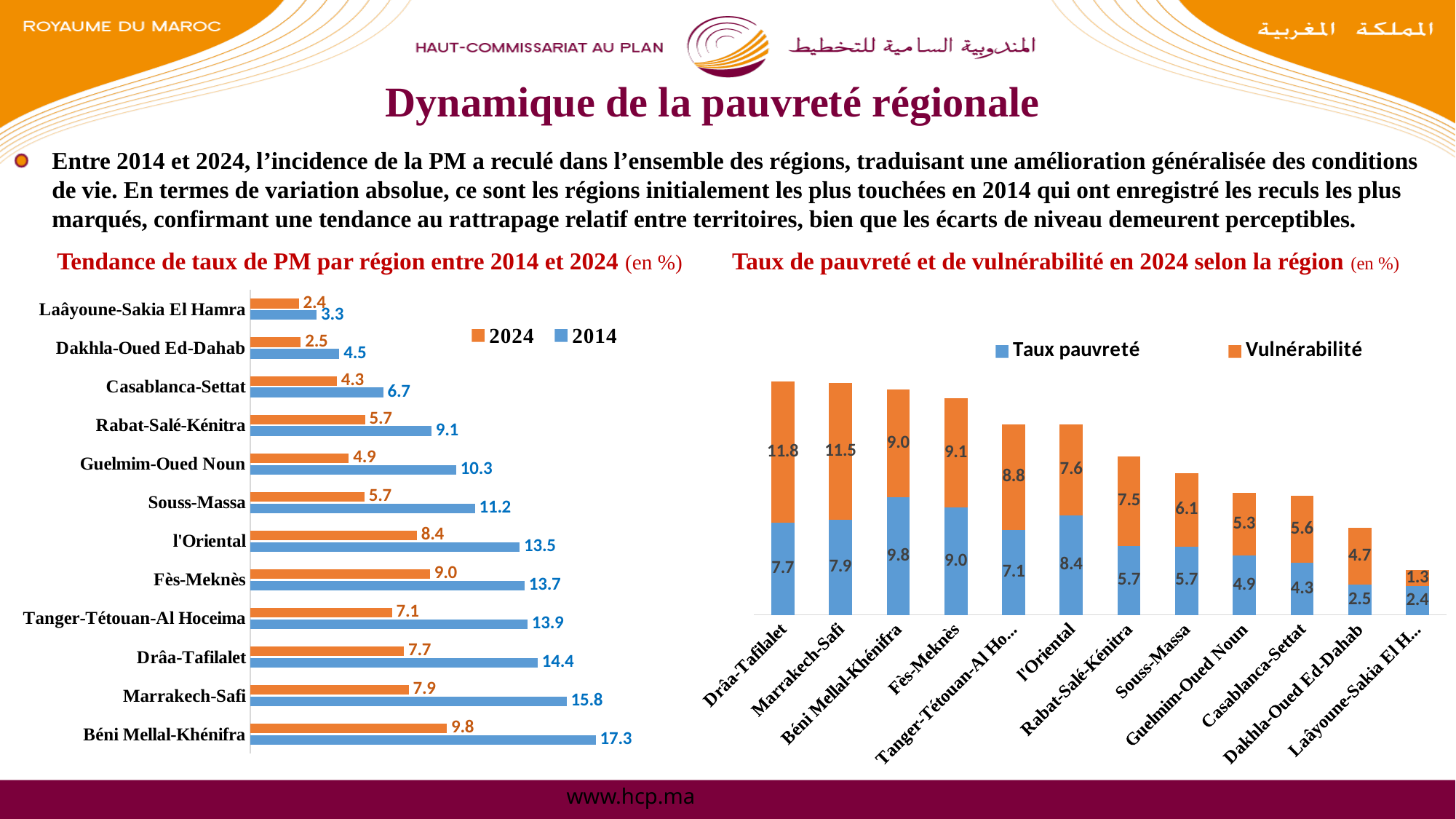
In the chart 'Tendance de taux de PM par région entre 2014 et 2024', which region has the lowest 2024 value? Laâyoune-Sakia El Hamra In the chart 'Taux de pauvreté et de vulnérabilité en 2024 selon la région', what is the Vulnérabilité value for Drâa-Tafilalet? 11.8 In the chart 'Taux de pauvreté et de vulnérabilité en 2024 selon la région', which region has the highest Taux pauvreté value? Béni Mellal-Khénifra In the chart 'Tendance de taux de PM par région entre 2014 et 2024', what is the 2014 value for Béni Mellal-Khénifra? 17.3 What kind of chart is 'Tendance de taux de PM par région entre 2014 et 2024'? Bar chart How many series does the legend of the chart 'Taux de pauvreté et de vulnérabilité en 2024 selon la région' list? 2 In the chart 'Taux de pauvreté et de vulnérabilité en 2024 selon la région', what is the total of the stacked bar for Marrakech-Safi? 19.4 In the chart 'Tendance de taux de PM par région entre 2014 et 2024', what is the 2024 value for Casablanca-Settat? 4.3 In the chart 'Tendance de taux de PM par région entre 2014 et 2024', how many regions are shown? 12 In the chart 'Tendance de taux de PM par région entre 2014 et 2024', what is the difference between the 2014 and 2024 values for Marrakech-Safi? 7.9 In the chart 'Tendance de taux de PM par région entre 2014 et 2024', which region has the highest 2014 value? Béni Mellal-Khénifra In the chart 'Taux de pauvreté et de vulnérabilité en 2024 selon la région', is the Vulnérabilité value larger for l'Oriental or for Souss-Massa? l'Oriental